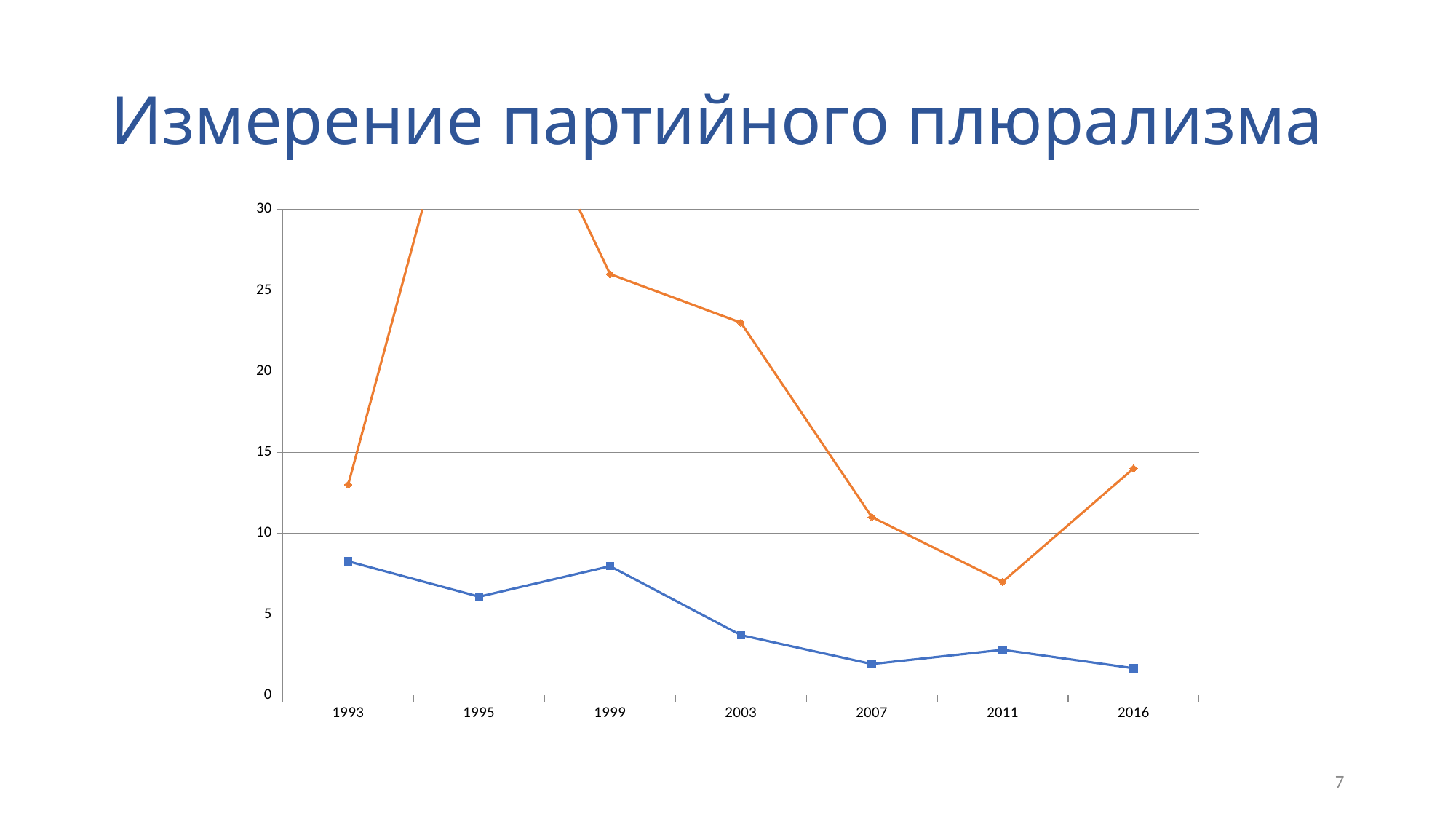
Is the value of the orange line for 2016 greater or less than 10? greater How many years are marked on the x axis of the chart? 7 How many lines are plotted on the chart? 2 What kind of chart is shown on the slide? line chart Is the value of the blue line for 2007 greater or less than 5? less For the orange line, which year has the lowest value? 2011 Does the blue line rise or fall from 1999 to 2007? fall Is the value of the orange line for 2011 greater or less than 10? less For the orange line, which is larger: the value for 2003 or the value for 2007? 2003 What is the title of the slide above the chart? Измерение партийного плюрализма